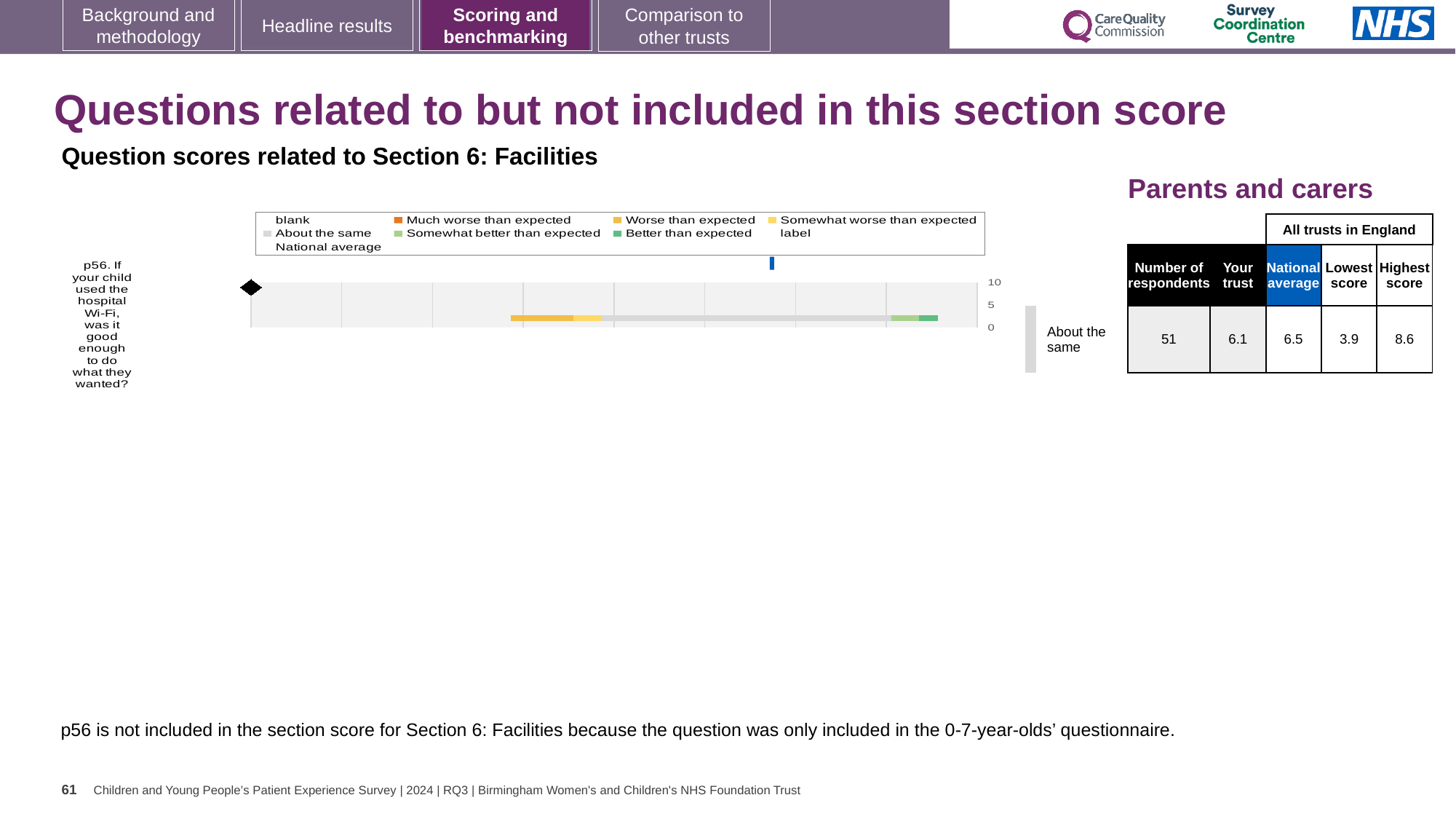
What is the highest score across all trusts in England for p56? 8.6 How many questions (categories) are plotted on the chart? 1 Which benchmark category label is shown next to the p56 bar? About the same For p56, which is larger: the 'Your trust' score or the national average? National average How many respondents answered p56 according to the table beside the chart? 51 What is the national average score for p56 in the table beside the chart? 6.5 What is the difference between the highest score and the lowest score for p56? 4.7 What is the difference between the national average and the 'Your trust' score for p56? 0.4 What kind of chart is used to show the p56 question score? bar chart What is the lowest score across all trusts in England for p56? 3.9 What is the 'Your trust' score for p56 in the table beside the chart? 6.1 What colour does the legend use for 'Much worse than expected'? orange